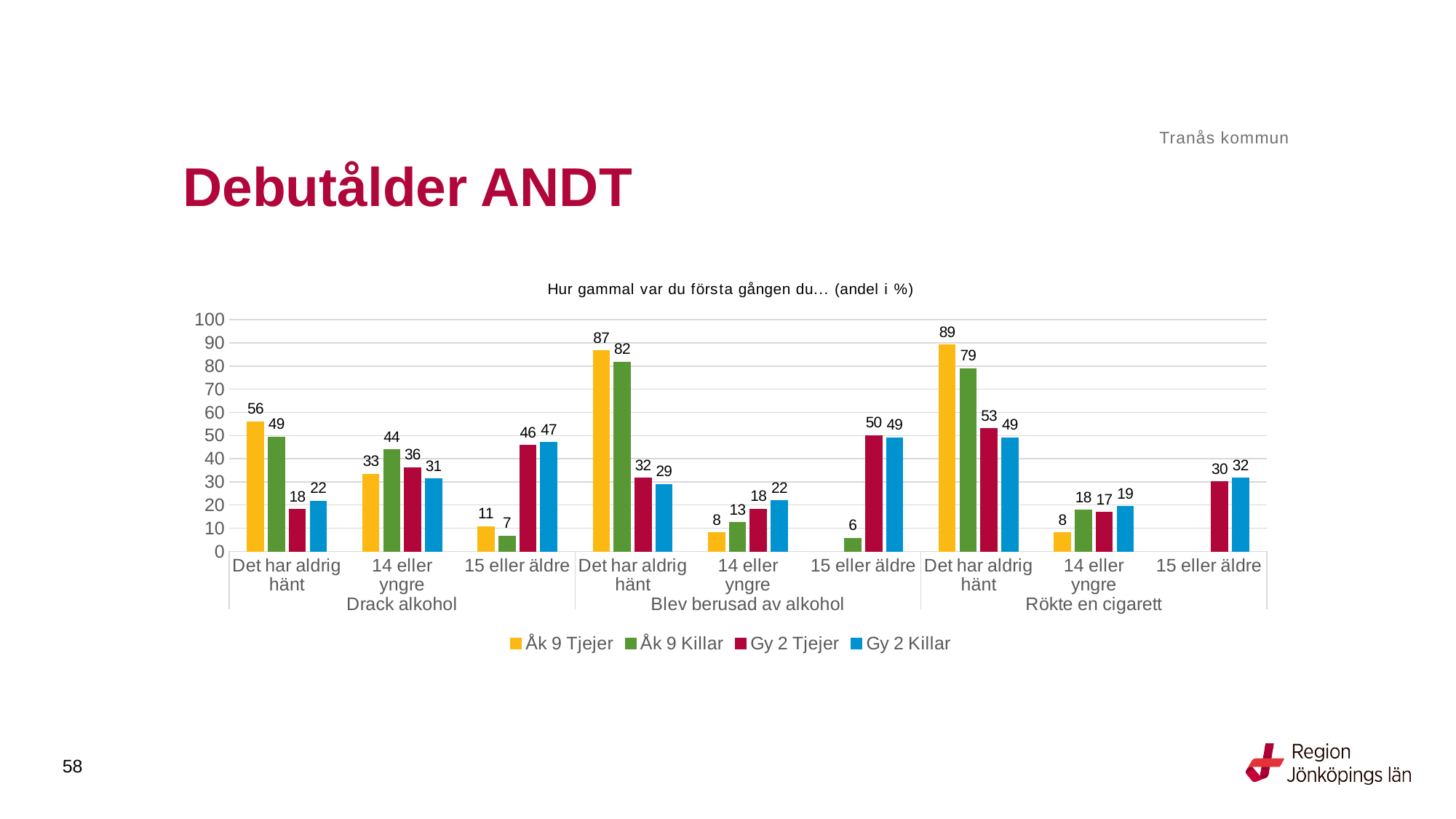
Is the value for Åk 9 Killar for 'Det har aldrig hänt' under 'Blev berusad av alkohol' greater or less than 70? greater How many category groups (questions) are shown along the x axis? 3 Which series has the lowest value for '15 eller äldre' under 'Drack alkohol'? Åk 9 Killar What is the value for Gy 2 Killar for '15 eller äldre' under 'Blev berusad av alkohol'? 49 What is the value for Åk 9 Killar for '14 eller yngre' under 'Rökte en cigarett'? 18 What is the value for Åk 9 Tjejer for 'Det har aldrig hänt' under 'Drack alkohol'? 56 Which is larger for '14 eller yngre' under 'Drack alkohol': Åk 9 Killar or Gy 2 Tjejer? Åk 9 Killar Which series has the highest value for 'Det har aldrig hänt' under 'Rökte en cigarett'? Åk 9 Tjejer What is the title of the chart? Hur gammal var du första gången du… (andel i %) How many series does the legend list? 4 What kind of chart is shown on the slide? bar chart What is the difference between Åk 9 Tjejer and Gy 2 Tjejer for 'Det har aldrig hänt' under 'Blev berusad av alkohol'? 55